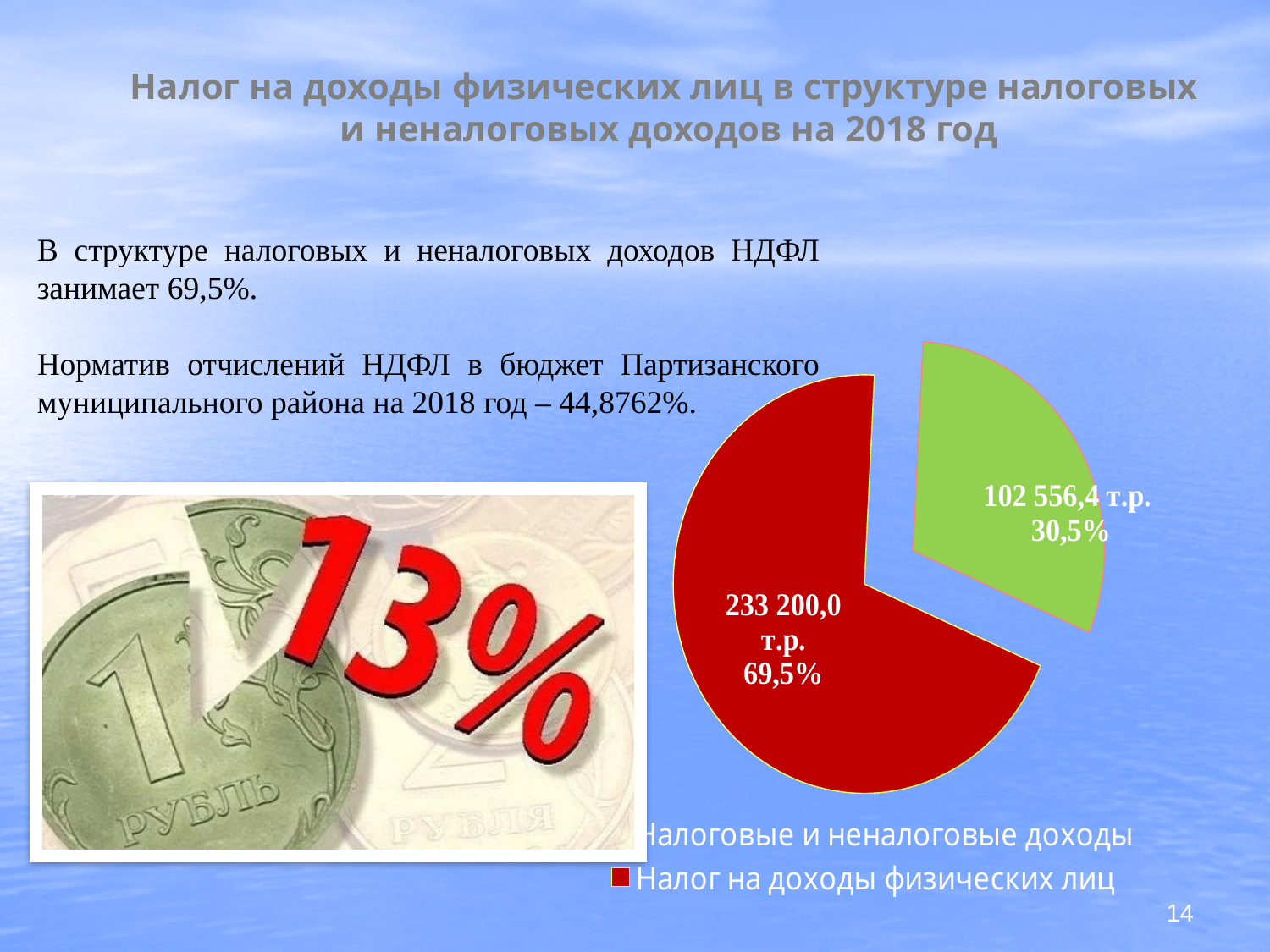
Which is larger in the pie chart: the red slice or the green slice? the red slice What is the difference in percentage points between the two slices of the pie chart? 39 percentage points Which slice of the pie chart is the largest? 233 200,0 т.р. (69,5%) What value is printed on the green slice of the pie chart? 102 556,4 т.р. How many slices does the pie chart have? 2 Which slice of the pie chart is the smallest? 102 556,4 т.р. (30,5%) What kind of chart is shown on the slide? pie chart Which legend entry is shown with a red marker in the pie chart? Налог на доходы физических лиц How many entries does the legend of the pie chart list? 2 What share of the pie does the slice labelled 102 556,4 т.р. represent? 30,5% What share of the pie does the slice labelled 233 200,0 т.р. represent? 69,5% What value is printed on the red slice of the pie chart? 233 200,0 т.р.